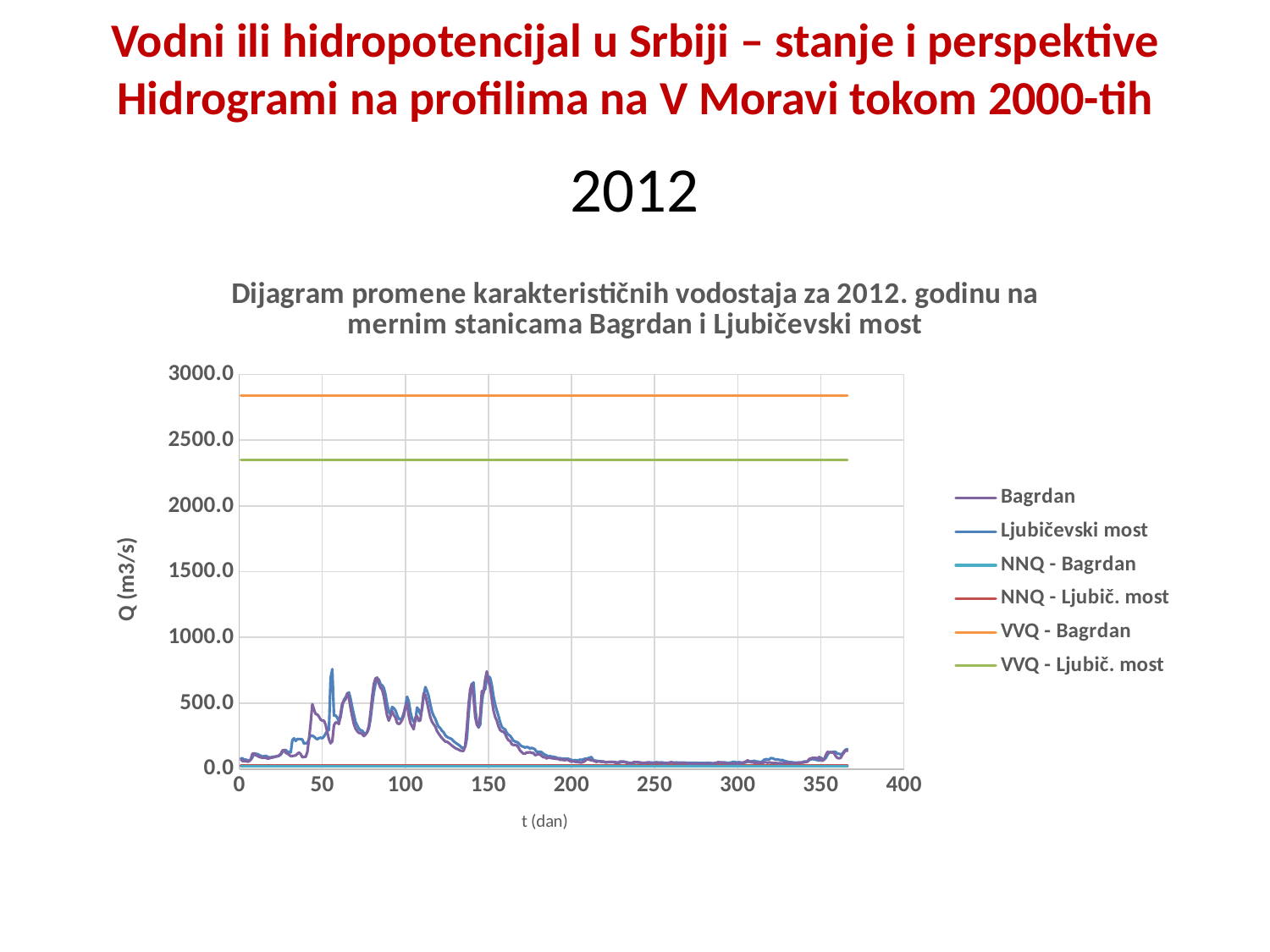
Is the value of the NNQ - Bagrdan line greater or less than 500? less Is the value of the VVQ - Ljubič. most line greater or less than 2000? greater What is the label of the horizontal axis of the chart? t (dan) What is the label of the vertical axis of the chart? Q (m3/s) Is the value of the Ljubičevski most series at day 300 greater or less than 500? less Which series has the highest values on the chart? VVQ - Bagrdan How many series does the chart legend list? 6 What kind of chart is shown on the slide? line chart Which is higher on the chart, the VVQ - Bagrdan line or the VVQ - Ljubič. most line? VVQ - Bagrdan